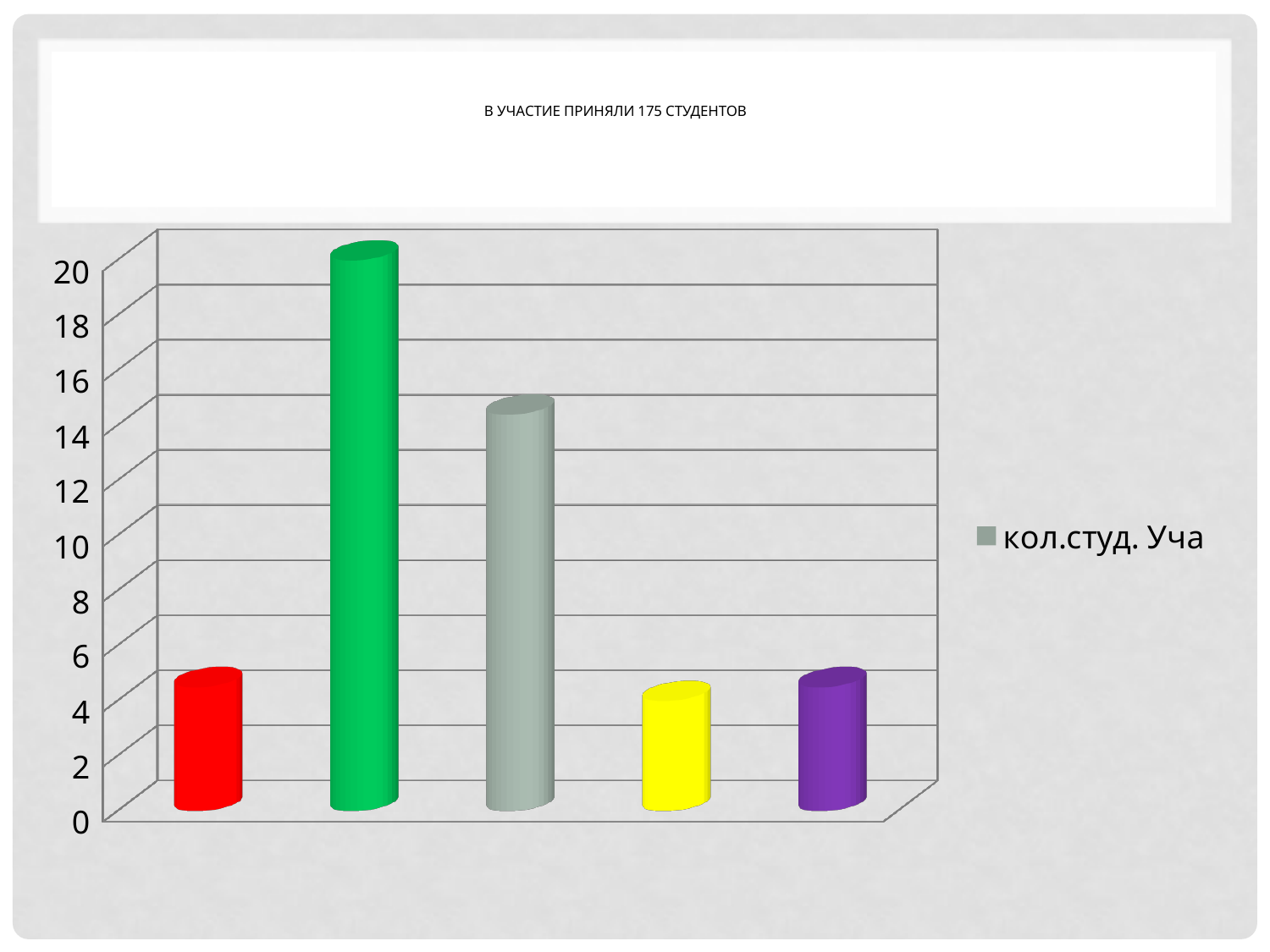
What text does the legend entry show? кол.студ. Уча Which is larger, the gray bar or the purple bar? the gray bar Is the value of the gray bar (third from left) greater or less than 16? less Is the value of the yellow bar (fourth from left) greater or less than 8? less Is the value of the red bar (first from left) greater or less than 10? less Which bar is the tallest in the chart? the green bar (second from left) How many series does the legend list? 1 How many bars are plotted in the chart? 5 What kind of chart is shown on the slide? bar chart Which is larger, the green bar or the gray bar? the green bar